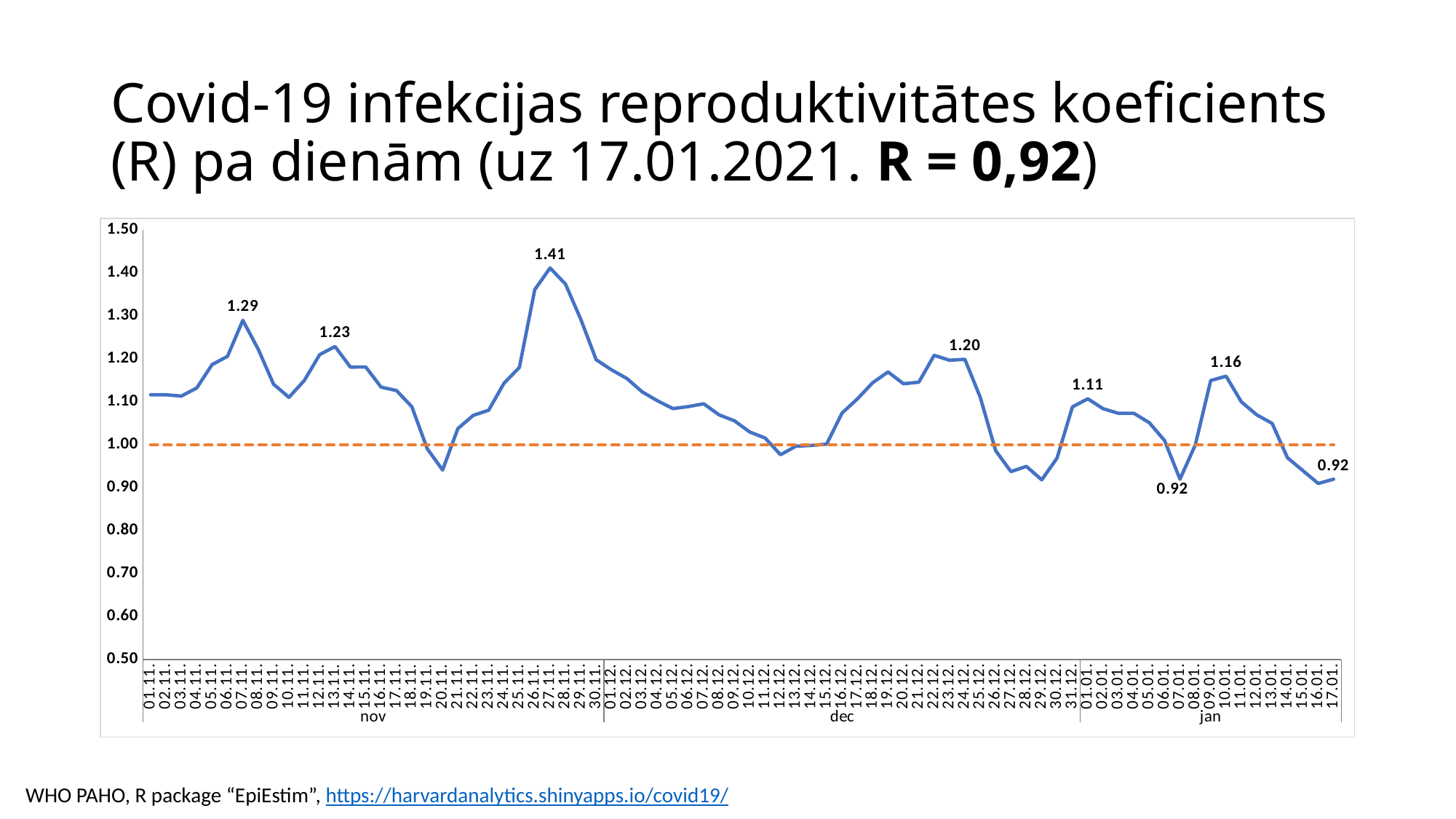
What is the difference between the labeled peak on 27.11. and the labeled peak on 07.11.? 0.12 Is the R value on 20.11. greater or less than 1.00? less What is the highest labeled R value on the chart? 1.41 Which months are labeled along the x axis? nov, dec, jan Which date has the higher labeled R value, 07.11. or 13.11.? 07.11. What is the R value labeled on 07.11.? 1.29 What is the R value labeled on 27.11.? 1.41 What type of chart is shown on the slide? line chart What is the R value labeled on 10.01.? 1.16 What is the R value labeled on 13.11.? 1.23 What is the R value labeled on 17.01.? 0.92 At what level is the dashed horizontal reference line drawn? 1.00